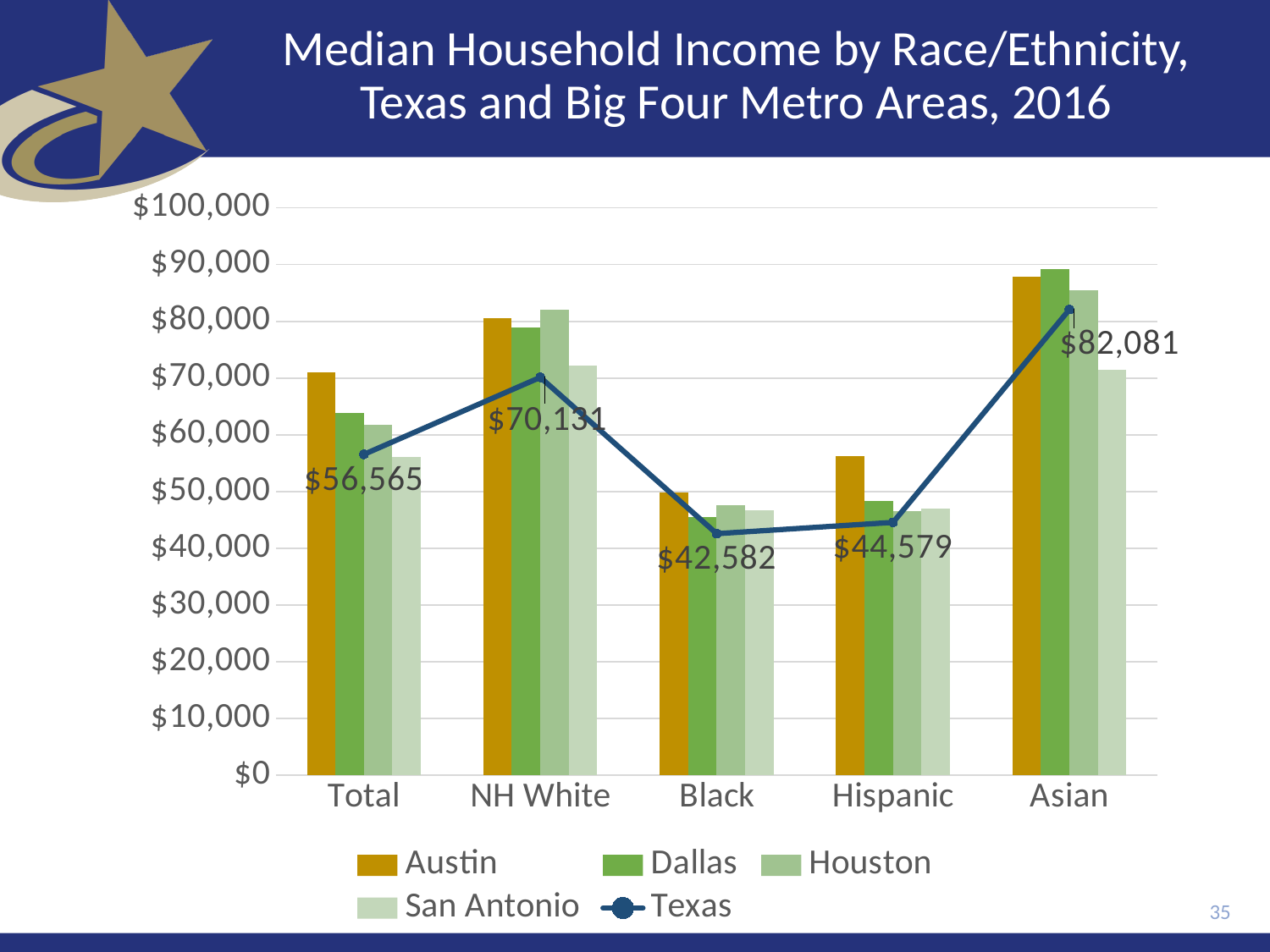
How many race/ethnicity categories are shown on the x axis? 5 How many series does the legend list? 5 Is the Texas median household income higher for Hispanic or Black households? Hispanic What is the Texas median household income for the Total category? $56,565 What is the Texas median household income for Black households? $42,582 Which race/ethnicity category has the lowest Texas median household income? Black Is the Austin value for Asian households greater or less than $80,000? greater Is the San Antonio value for the Total category greater or less than $60,000? less Which series is plotted as a line rather than bars? Texas What is the Texas median household income for Asian households? $82,081 What is the difference between the Texas median household income for Asian and Black households? $39,499 Which race/ethnicity category has the highest Texas median household income? Asian